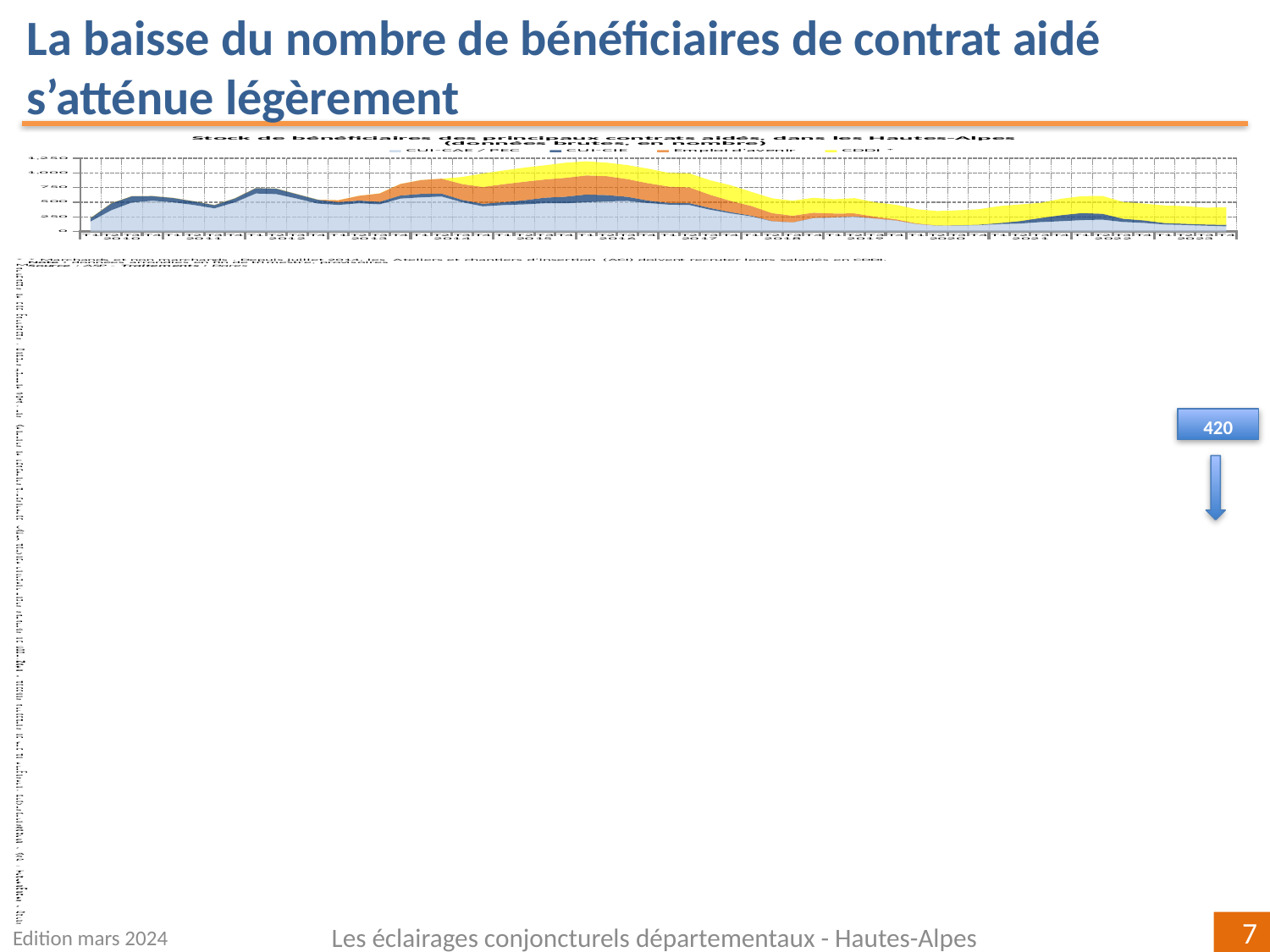
Which series is listed first in the chart's legend? CUI-CAE / PEC What number is shown in the blue callout box to the right of the chart? 420 Does the total stock of beneficiaries rise or fall between 2016 and 2019? Fall What kind of chart is shown on the slide? Stacked area chart Does the total stock of beneficiaries rise or fall between 2010 and 2015? Rise Is the total stock of beneficiaries in 2015 greater or less than 750? greater Is the total stock of beneficiaries in 2019 greater or less than 750? less Which year is labelled first on the x axis of the chart? 2010 How many series does the chart's legend list? 4 Is the total stock of beneficiaries in 2023 greater or less than 500? less What is the highest value shown on the chart's y axis? 1,250 How many years are labelled on the x axis of the chart? 14